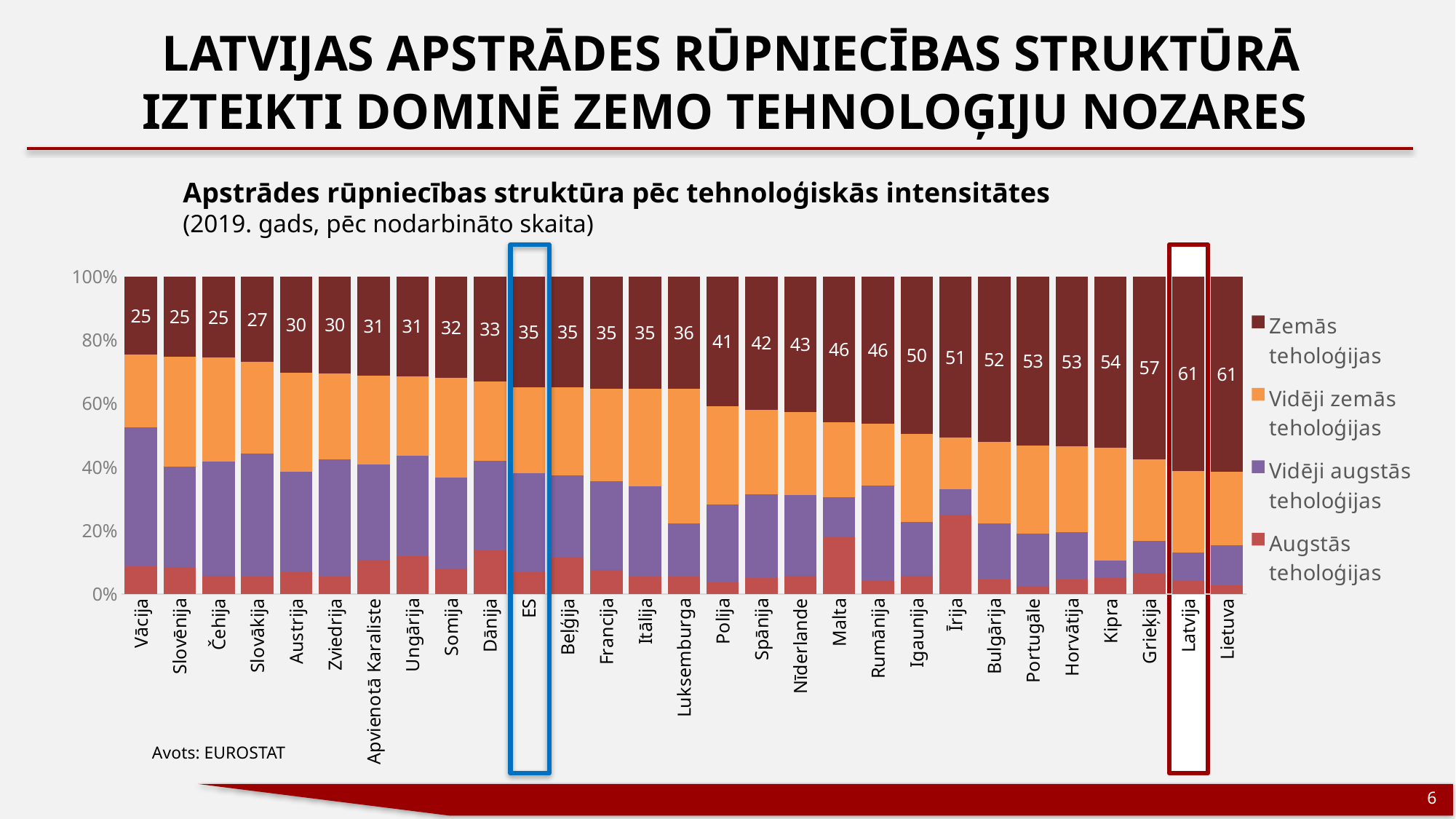
What is the Zemās tehnoloģijas share for Vācija? 25 Which has a larger Zemās tehnoloģijas share, Īrija or Somija? Īrija What is the Zemās tehnoloģijas share for ES? 35 What is the Zemās tehnoloģijas share for Latvija? 61 What is the difference between the Zemās tehnoloģijas share for Latvija and for ES? 26 How many countries/regions are shown on the x axis of the chart? 29 How many series does the legend list? 4 What kind of chart is shown on the slide? Stacked bar chart What is the Zemās tehnoloģijas share for Malta? 46 Do the Zemās tehnoloģijas values rise or fall from left to right along the x axis? Rise Is the Augstās tehnoloģijas share for Īrija greater or less than 20%? greater Which country's bar is highlighted with a red box? Latvija